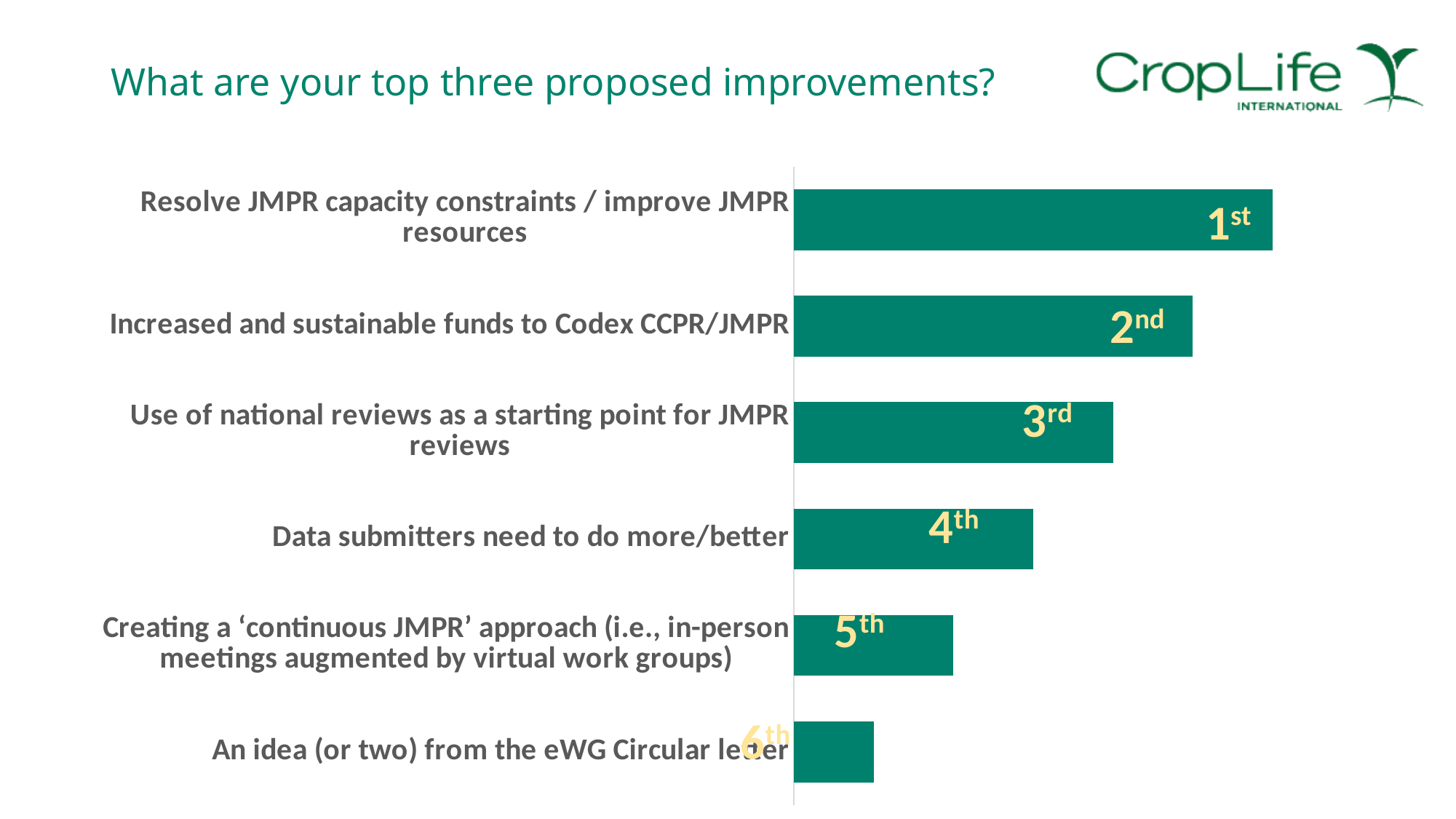
What rank label is printed on the bar for 'Increased and sustainable funds to Codex CCPR/JMPR'? 2nd Do the bar lengths increase or decrease going from the top category to the bottom category? decrease What rank label is printed on the bar for 'Use of national reviews as a starting point for JMPR reviews'? 3rd How many categories (proposed improvements) are plotted in the chart? 6 Which has the longer bar: 'Use of national reviews as a starting point for JMPR reviews' or 'Data submitters need to do more/better'? Use of national reviews as a starting point for JMPR reviews Which proposed improvement has the shortest bar? An idea (or two) from the eWG Circular letter What rank label is printed on the bar for 'Data submitters need to do more/better'? 4th What kind of chart is shown on the slide? bar chart Which proposed improvement has the longest bar? Resolve JMPR capacity constraints / improve JMPR resources What colour are the bars in the chart? green Which proposed improvement is labelled 5th? Creating a 'continuous JMPR' approach (i.e., in-person meetings augmented by virtual work groups) What is the title of the slide containing the chart? What are your top three proposed improvements?